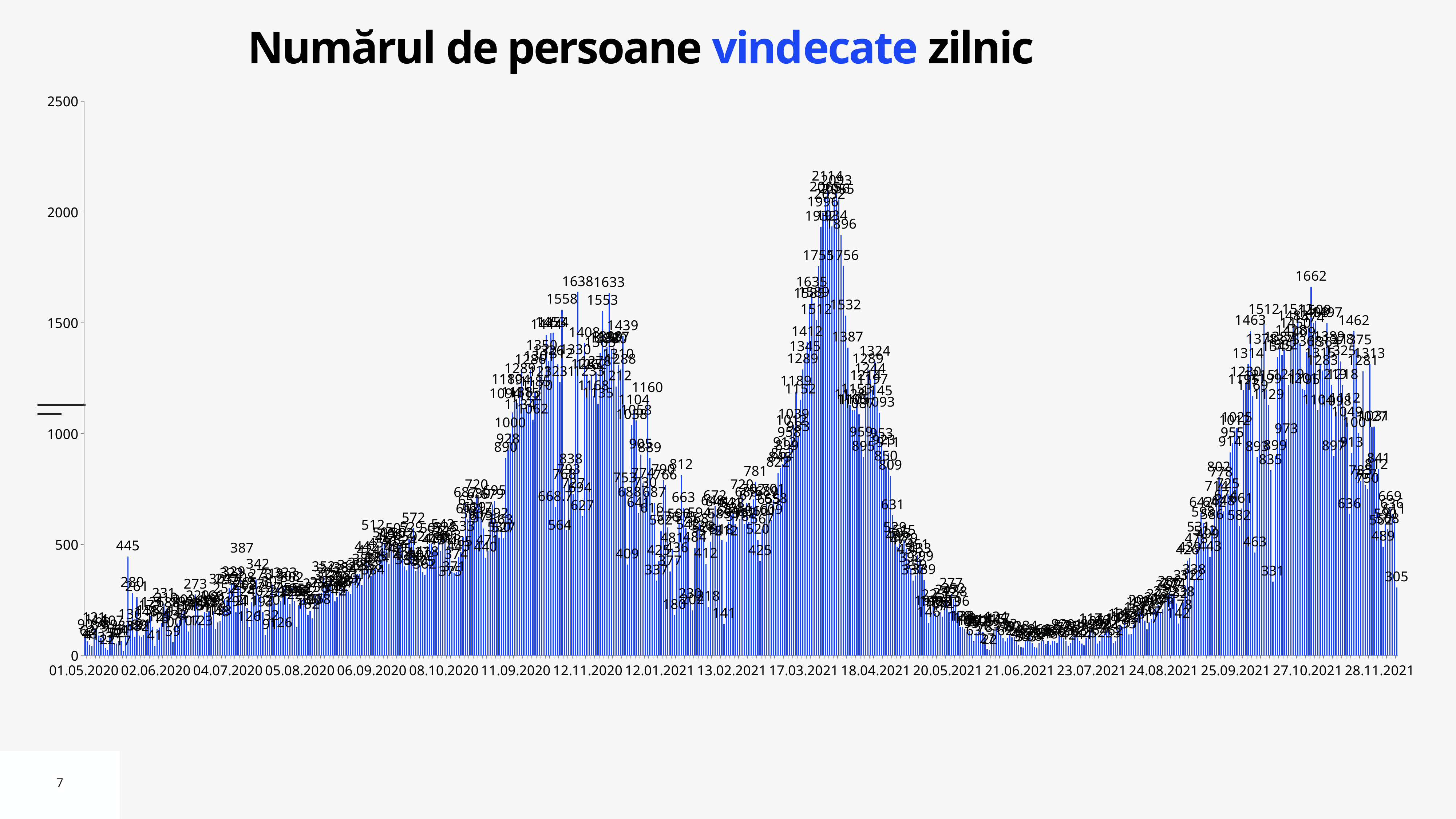
Which wave reaches a higher peak: the one around 17.03.2021 or the one around 27.10.2021? the one around 17.03.2021 What is the highest value labelled on the chart? 2114 What is the highest labelled value in the wave around 27.10.2021? 1662 Is the peak value around 17.03.2021 greater or less than 2000? greater What is the highest tick value shown on the vertical axis? 2500 Do the values rise or fall between 21.06.2021 and 27.10.2021? rise What is the value of the last bar on the chart, at 28.11.2021? 305 What is the difference between the peak of the autumn 2021 wave (1662) and the peak of the autumn 2020 wave (1638)? 24 What is the highest labelled value in the wave around 12.11.2020? 1638 Are the values around 21.06.2021 greater or less than 500? less What is the title of the chart? Numărul de persoane vindecate zilnic What kind of chart is shown on the slide? bar chart